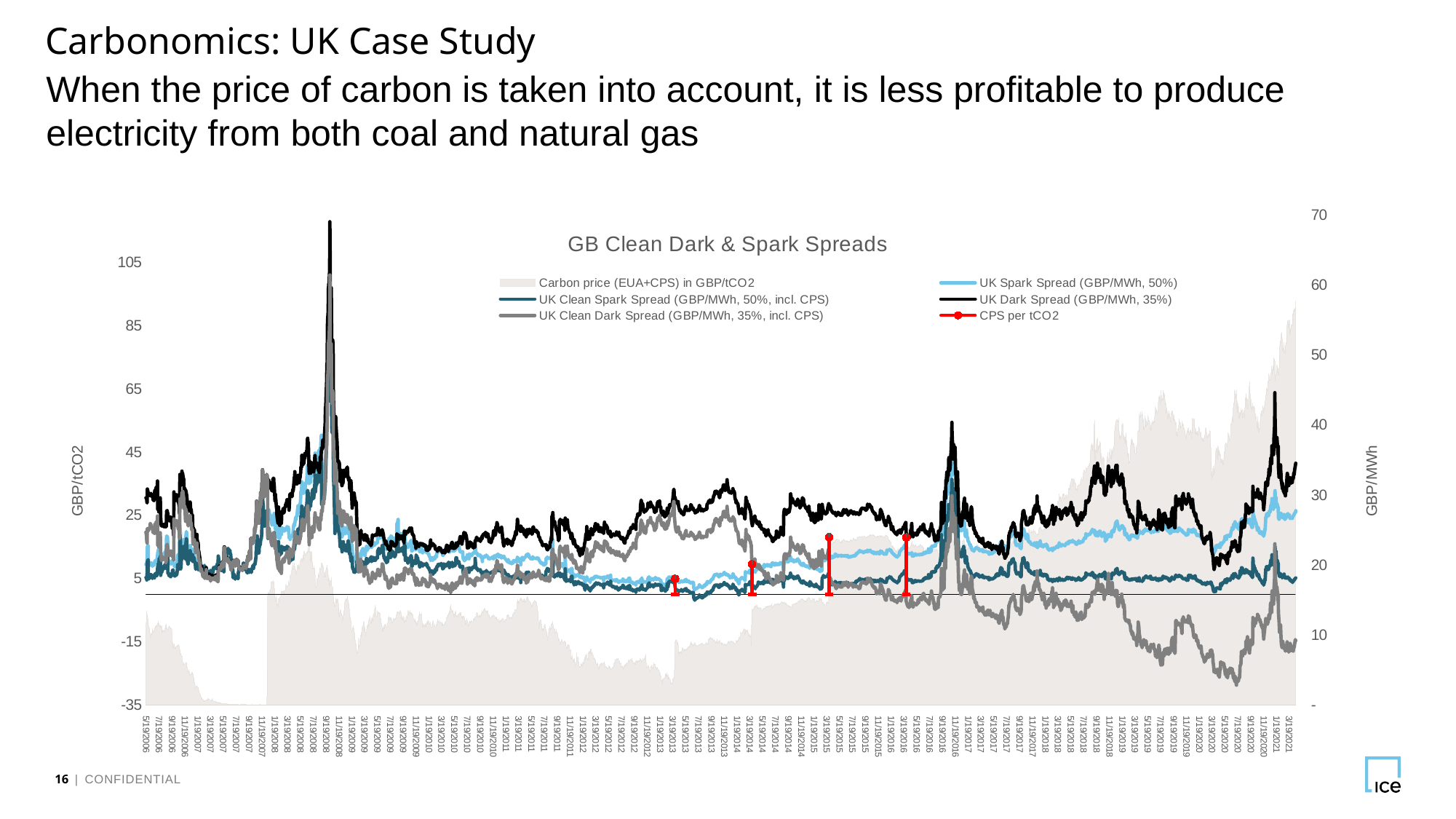
How many series does the chart legend list? 6 Which series is higher in 2020: UK Spark Spread (GBP/MWh, 50%) or UK Clean Spark Spread (GBP/MWh, 50%, incl. CPS)? UK Spark Spread (GBP/MWh, 50%) Which series is higher at the end of the period in 2021: UK Dark Spread (GBP/MWh, 35%) or UK Clean Dark Spread (GBP/MWh, 35%, incl. CPS)? UK Dark Spread (GBP/MWh, 35%) What kind of chart is shown on the slide? line chart Is the peak value of the UK Dark Spread (GBP/MWh, 35%) series, reached around 2008, greater or less than 60 on the right-hand axis? greater Which series has the highest peak on the chart? UK Dark Spread (GBP/MWh, 35%) Does the Carbon price (EUA+CPS) in GBP/tCO2 series generally rise or fall between 2017 and 2021? rise Is the highest value of the Carbon price (EUA+CPS) in GBP/tCO2 series, reached at the end of the period, greater or less than 65 on the left-hand axis? greater What is the label of the right-hand vertical axis? GBP/MWh Is the lowest value of the UK Clean Dark Spread (GBP/MWh, 35%, incl. CPS) series, reached around 2020, greater or less than 10 on the right-hand axis? less What is the title of the chart? GB Clean Dark & Spark Spreads